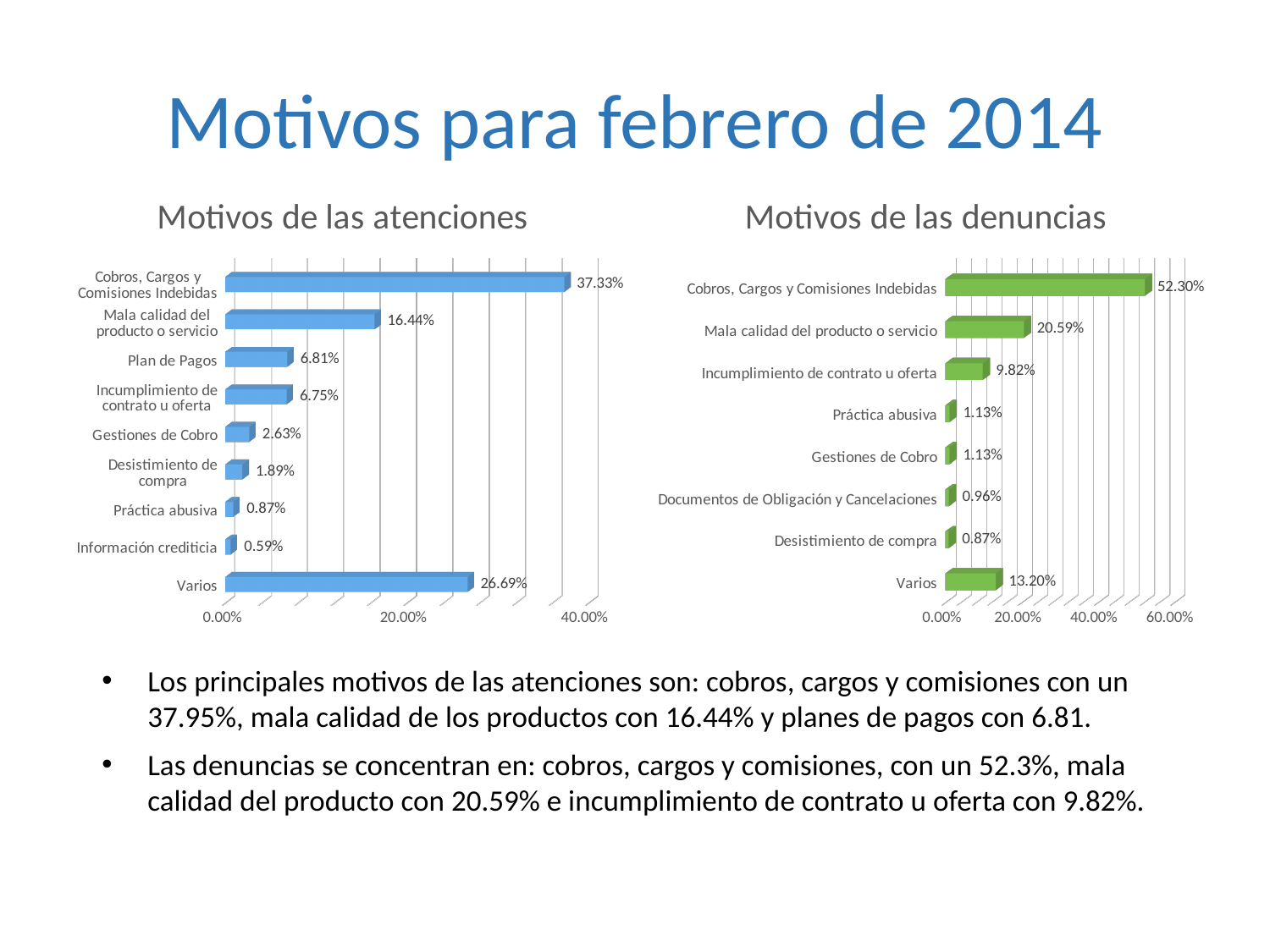
In the 'Motivos de las atenciones' chart, what is the value for Varios? 26.69% In the 'Motivos de las denuncias' chart, which category has the highest value? Cobros, Cargos y Comisiones Indebidas In the 'Motivos de las atenciones' chart, how many categories are shown? 9 In the 'Motivos de las atenciones' chart, what is the difference between Mala calidad del producto o servicio and Plan de Pagos? 9.63% In the 'Motivos de las atenciones' chart, what is the value for Cobros, Cargos y Comisiones Indebidas? 37.33% In the 'Motivos de las atenciones' chart, which category has the lowest value? Información crediticia In the 'Motivos de las denuncias' chart, how many categories are shown? 8 What type of chart is 'Motivos de las denuncias'? Bar chart In the 'Motivos de las denuncias' chart, what is the value for Incumplimiento de contrato u oferta? 9.82% In the 'Motivos de las denuncias' chart, what is the difference between Mala calidad del producto o servicio and Varios? 7.39% In the 'Motivos de las atenciones' chart, which is larger: Gestiones de Cobro or Desistimiento de compra? Gestiones de Cobro In the 'Motivos de las denuncias' chart, what is the value for Cobros, Cargos y Comisiones Indebidas? 52.30%